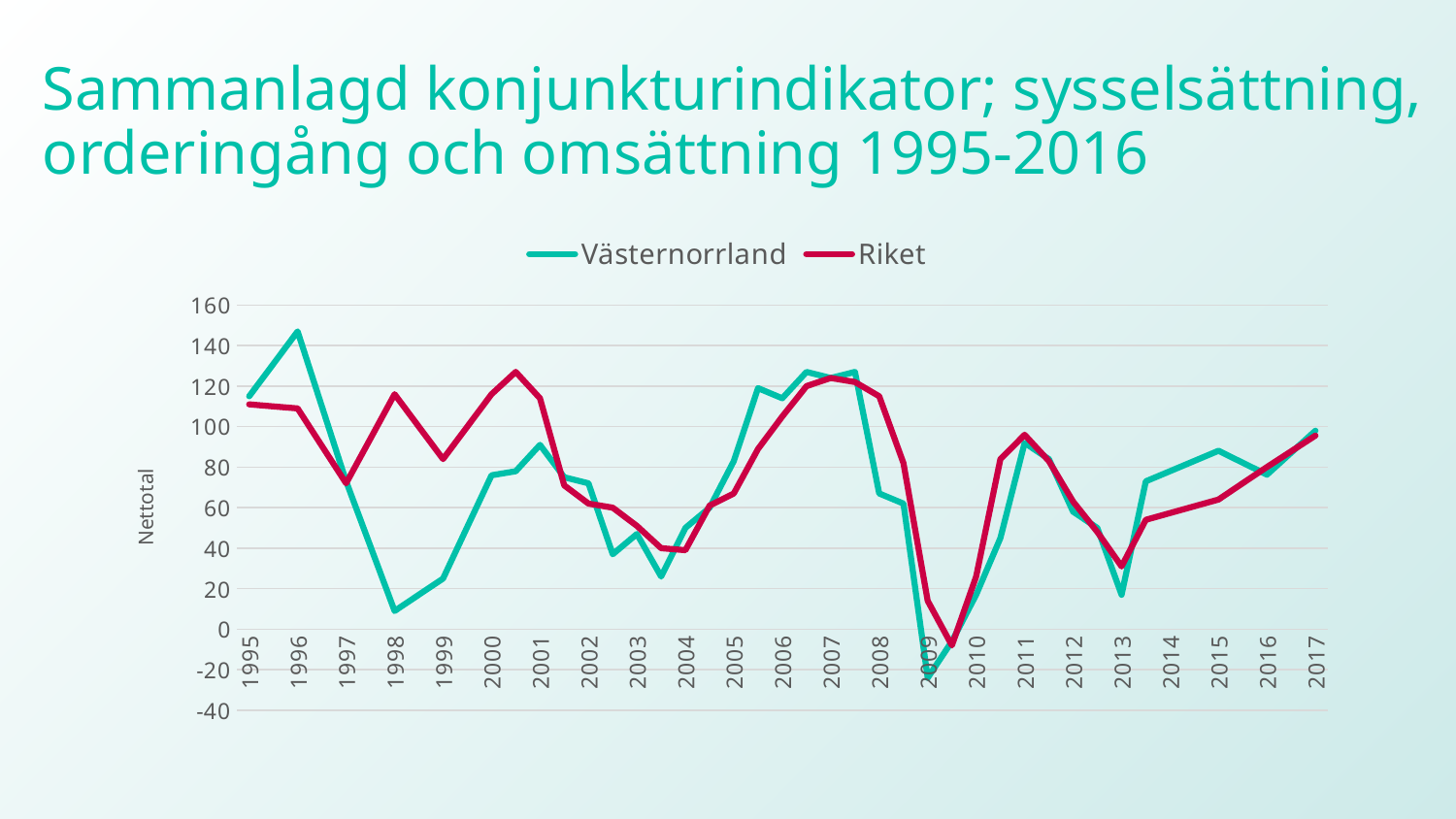
Is the value for Västernorrland in 1998 greater or less than 40? less What kind of chart is shown on the slide? line chart How many year labels are shown on the x axis? 23 In which year does the Västernorrland series reach its lowest value? 2009 What is the label on the vertical axis? Nettotal Is the value for Västernorrland in 1996 greater or less than 120? greater Is the value for Riket in 1998 greater or less than 100? greater In 1998, which series has the larger value, Västernorrland or Riket? Riket How many series does the legend list? 2 What are the two series named in the legend? Västernorrland and Riket In which year does the Västernorrland series reach its highest value? 1996